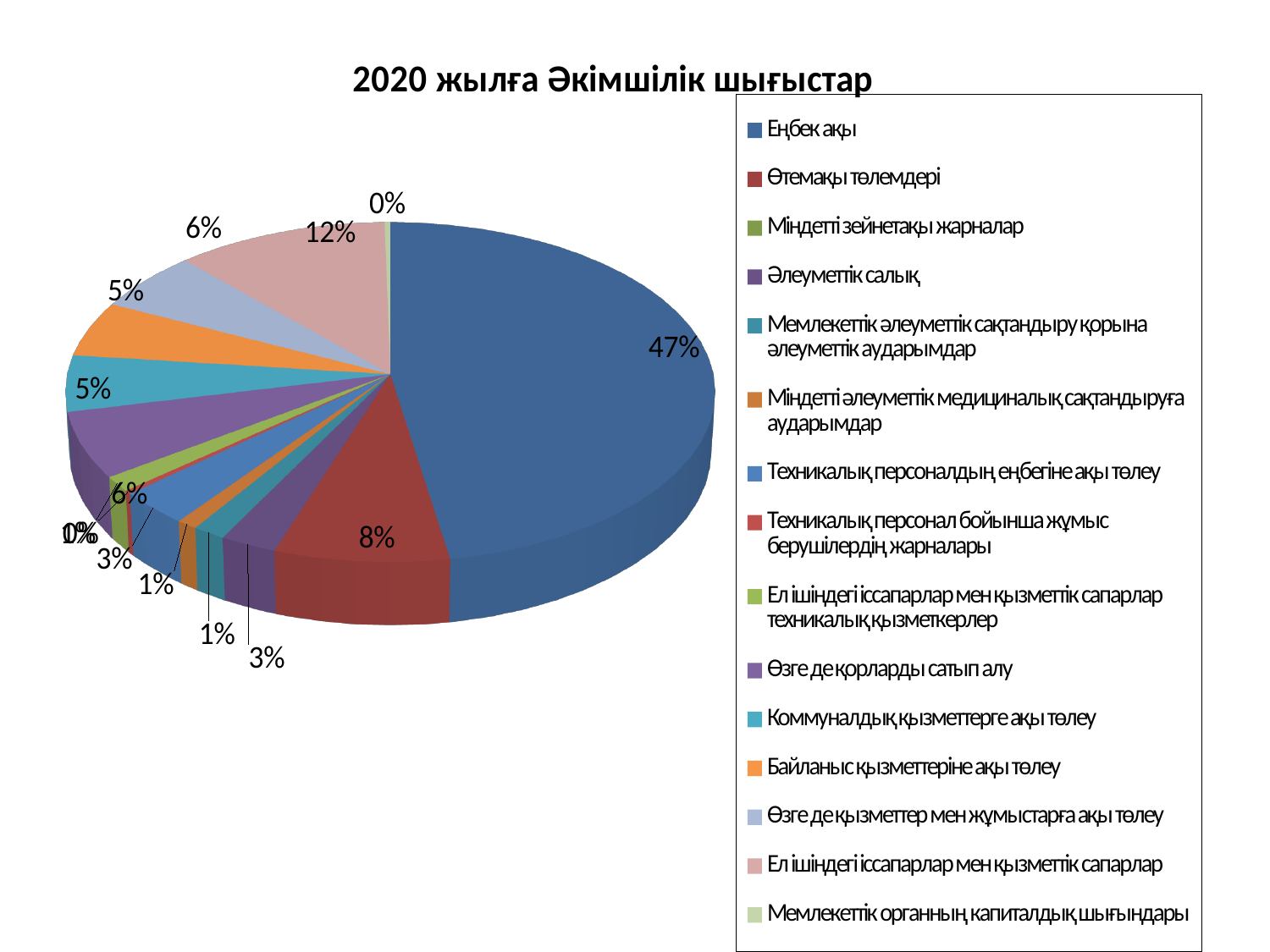
What share of the pie is Байланыс қызметтеріне ақы төлеу? 5% Which is larger, the share for Еңбек ақы or the share for Өтемақы төлемдері? Еңбек ақы What type of chart is shown on the slide? pie chart Which category has the largest share of the pie? Еңбек ақы How many categories does the legend list? 15 What is the title of the chart? 2020 жылға Әкімшілік шығыстар What share of the pie is Ел ішіндегі іссапарлар мен қызметтік сапарлар? 12% What share of the pie is Мемлекеттік органның капиталдық шығындары? 0% What is the difference in percentage points between the share for Еңбек ақы and the share for Ел ішіндегі іссапарлар мен қызметтік сапарлар? 35